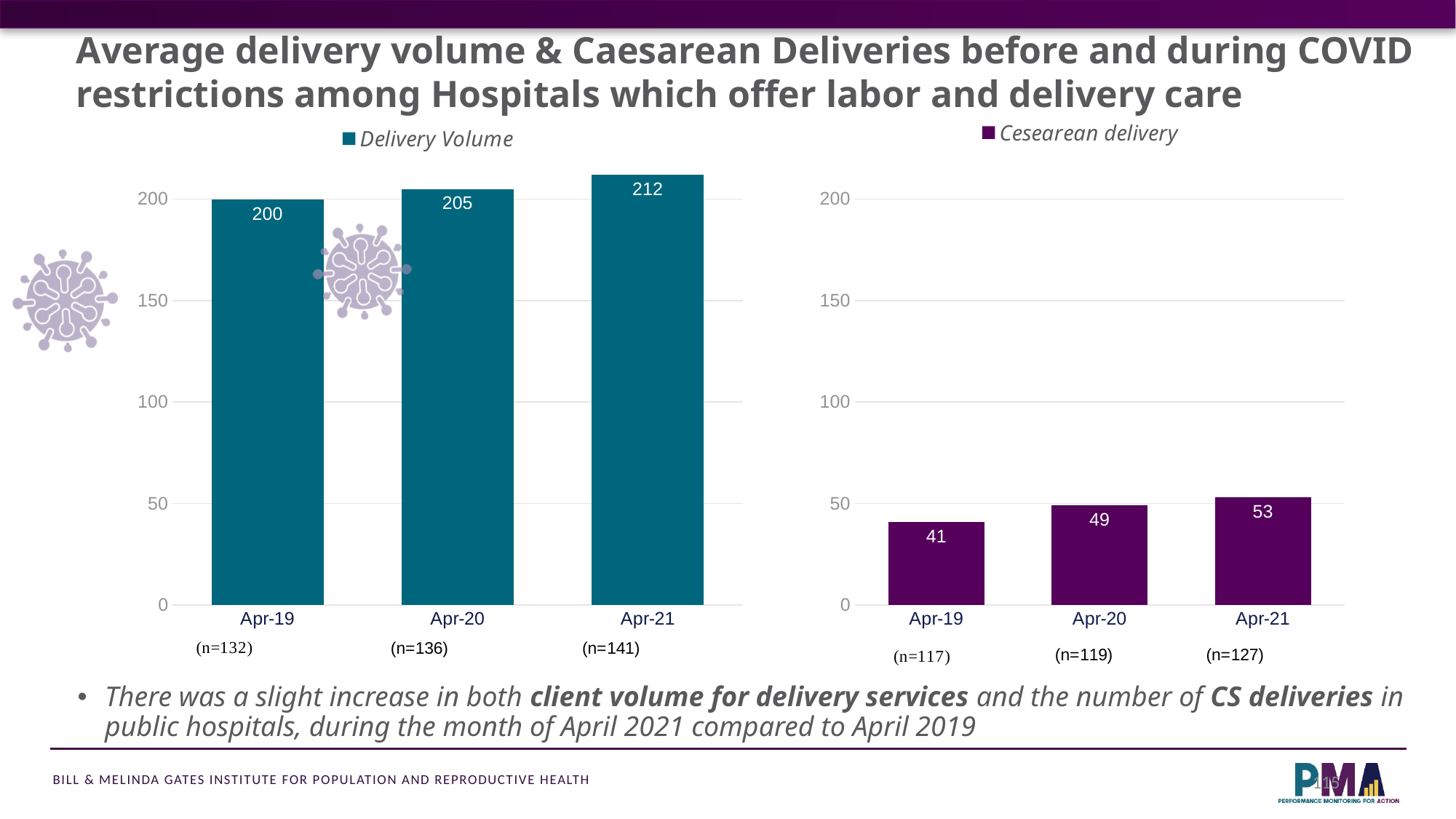
How many categories are shown in the Delivery Volume chart? 3 In the Cesearean delivery chart, which category has the highest value? Apr-21 In the Delivery Volume chart, what is the difference between the Apr-21 and Apr-19 values? 12 In the Delivery Volume chart, which category has the lowest value? Apr-19 In the Cesearean delivery chart, what is the difference between the Apr-20 and Apr-19 values? 8 In the Cesearean delivery chart, is the value for Apr-19 greater or less than 50? less In the Delivery Volume chart, do the values rise or fall from Apr-19 to Apr-21? rise What kind of chart is the Cesearean delivery chart? bar chart In the Delivery Volume chart, what is the value for Apr-19? 200 In the Cesearean delivery chart, which is larger, the value for Apr-20 or Apr-21? Apr-21 In the Cesearean delivery chart, what is the value for Apr-19? 41 In the Delivery Volume chart, what is the value for Apr-21? 212